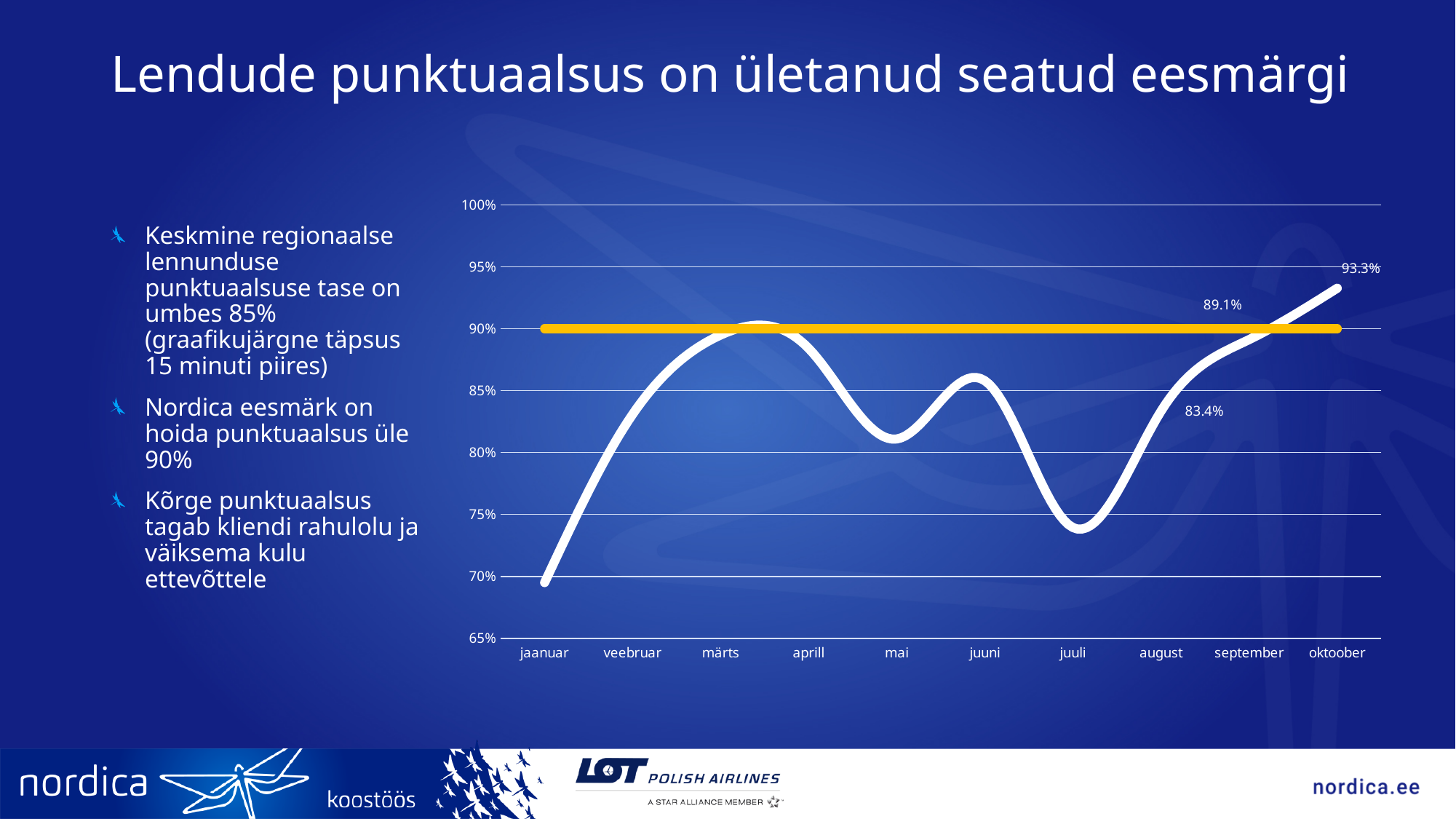
Is the value for jaanuar greater or less than 75%? less What is the value for oktoober? 93.3% What is the difference between the values for september and august? 5.7 percentage points Which is larger, the value for oktoober or the value for august? oktoober How many months are shown on the x axis? 10 Which month has the highest value? oktoober Which month has the lowest value? jaanuar What kind of chart is shown on the slide? line chart What is the value for august? 83.4% What is the difference between the values for oktoober and september? 4.2 percentage points What is the value for september? 89.1% Is the value for juuli greater or less than 80%? less